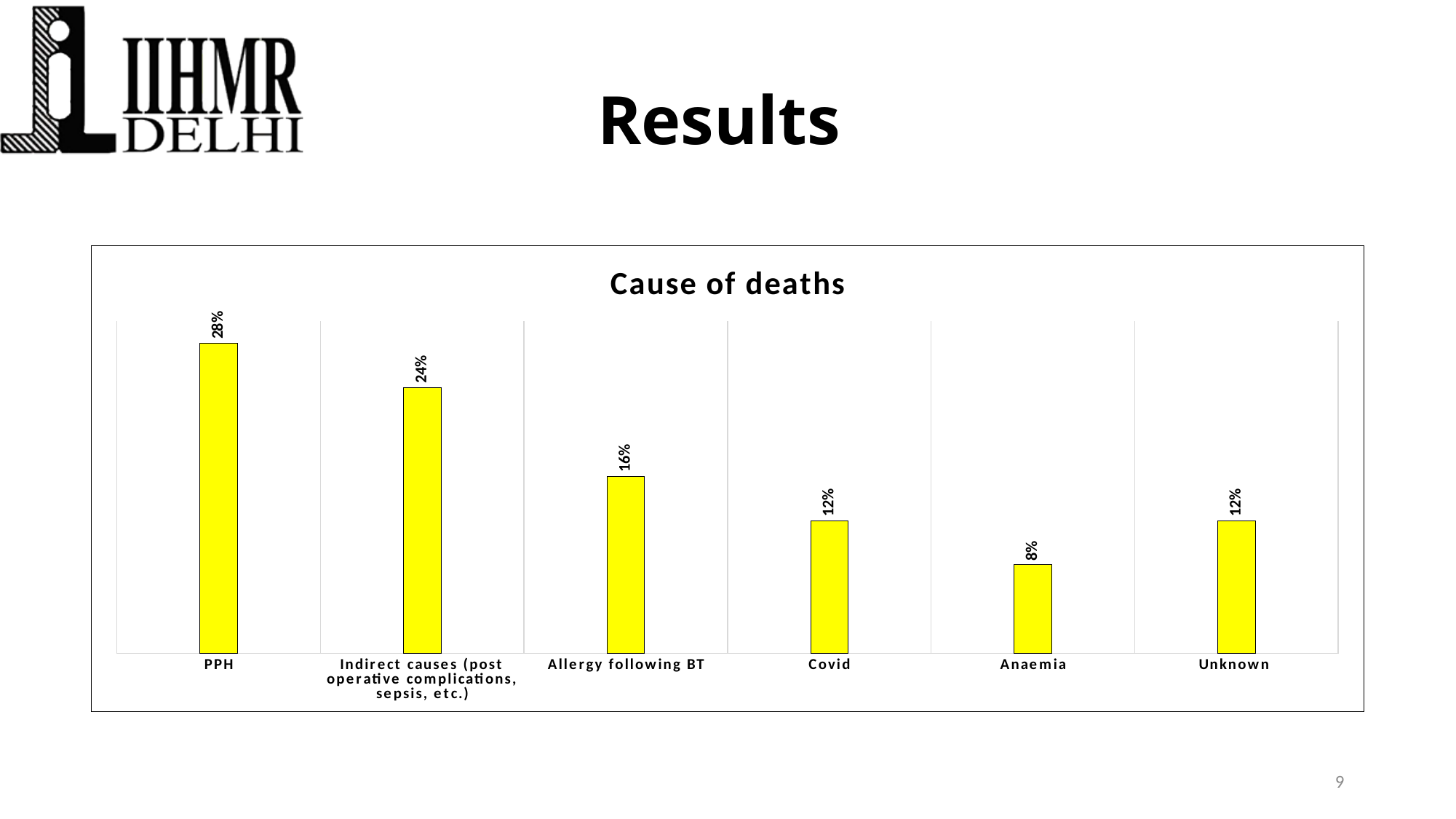
What is the difference between the values for Allergy following BT and Anaemia? 8% Which is larger, the value for Indirect causes or the value for Allergy following BT? Indirect causes What kind of chart is shown on the slide? Bar chart What is the value for Allergy following BT? 16% What is the difference between the values for PPH and Covid? 16% What is the value for Indirect causes (post operative complications, sepsis, etc.)? 24% What is the value for Anaemia in the Cause of deaths chart? 8% Which cause of death has the highest value? PPH What is the value for PPH in the Cause of deaths chart? 28% How many categories are shown in the Cause of deaths chart? 6 Which cause of death has the lowest value? Anaemia What is the title of the chart? Cause of deaths